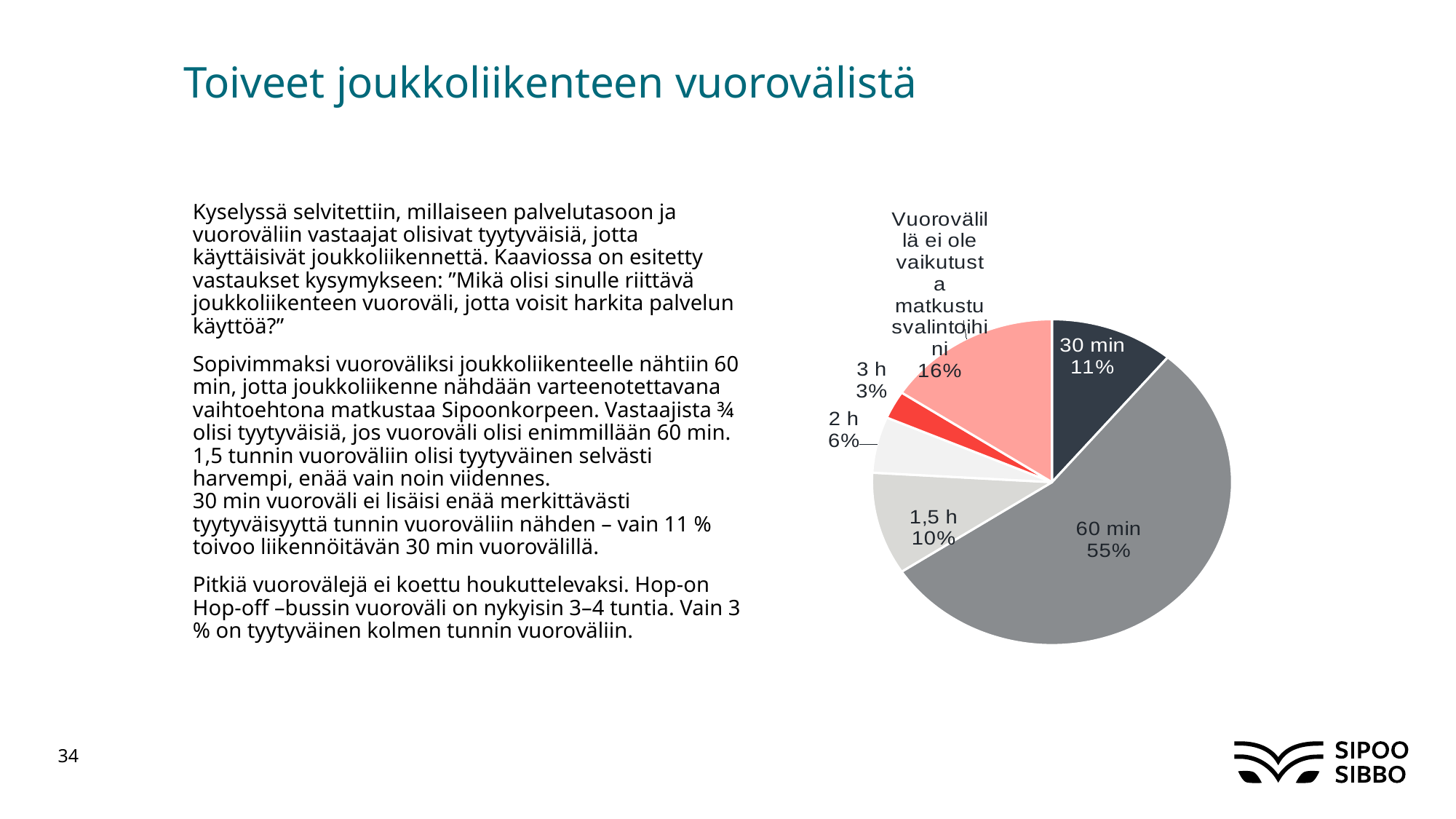
What share of the pie does the 60 min slice have? 55% Which slice of the pie chart is the smallest? 3 h What share of the pie does the 3 h slice have? 3% What is the difference in percentage points between the 60 min slice and the 30 min slice? 44 What share of the pie does the 1,5 h slice have? 10% What kind of chart is shown on the slide? pie chart Which is larger, the 2 h slice or the 1,5 h slice? 1,5 h Which slice of the pie chart is the largest? 60 min How many slices does the pie chart have? 6